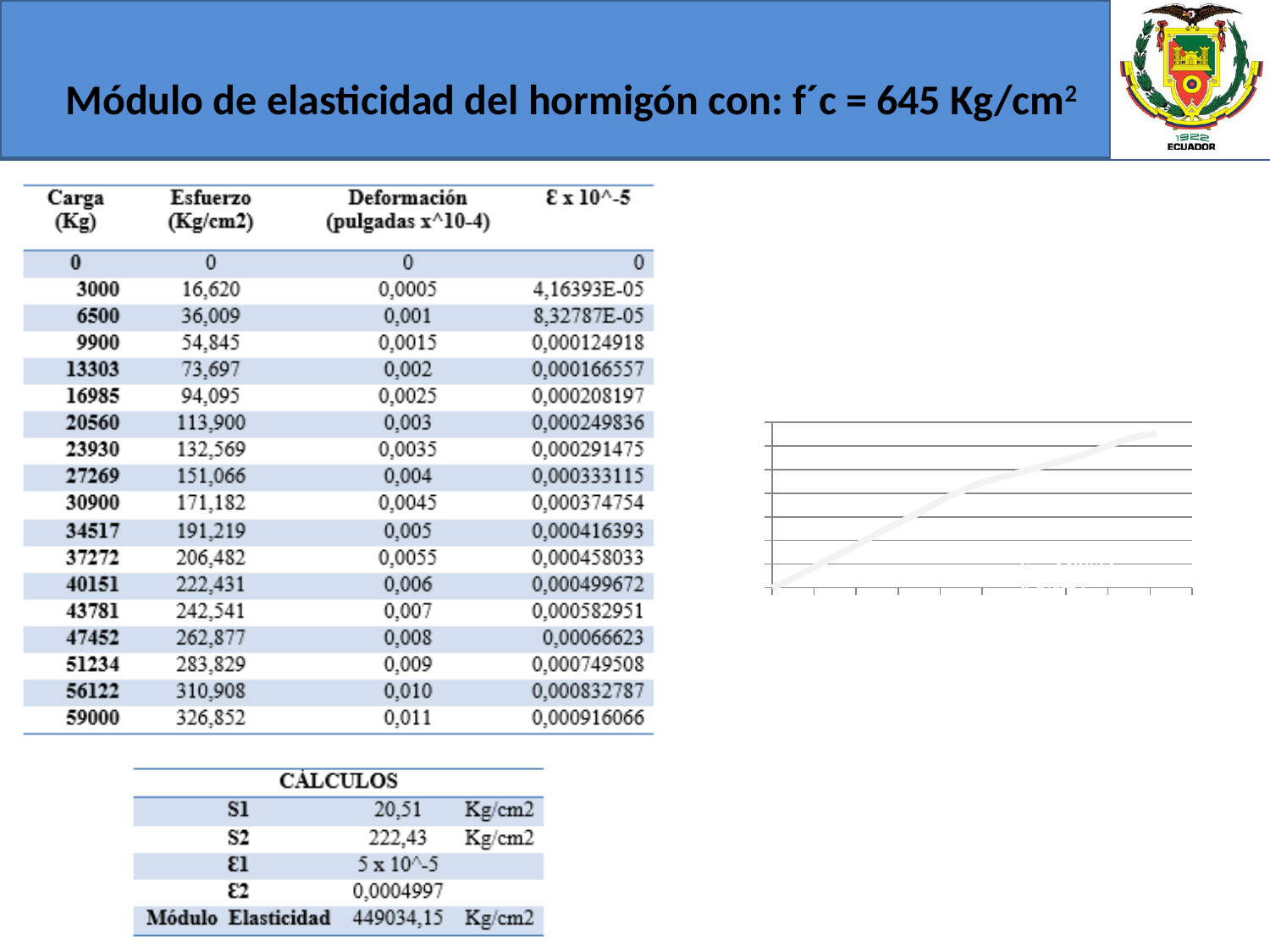
How many lines are plotted in the chart on the right side of the slide? 1 In the chart on the right side of the slide, do the plotted values rise or fall from left to right along the x axis? rise What kind of chart is shown on the right side of the slide? line chart